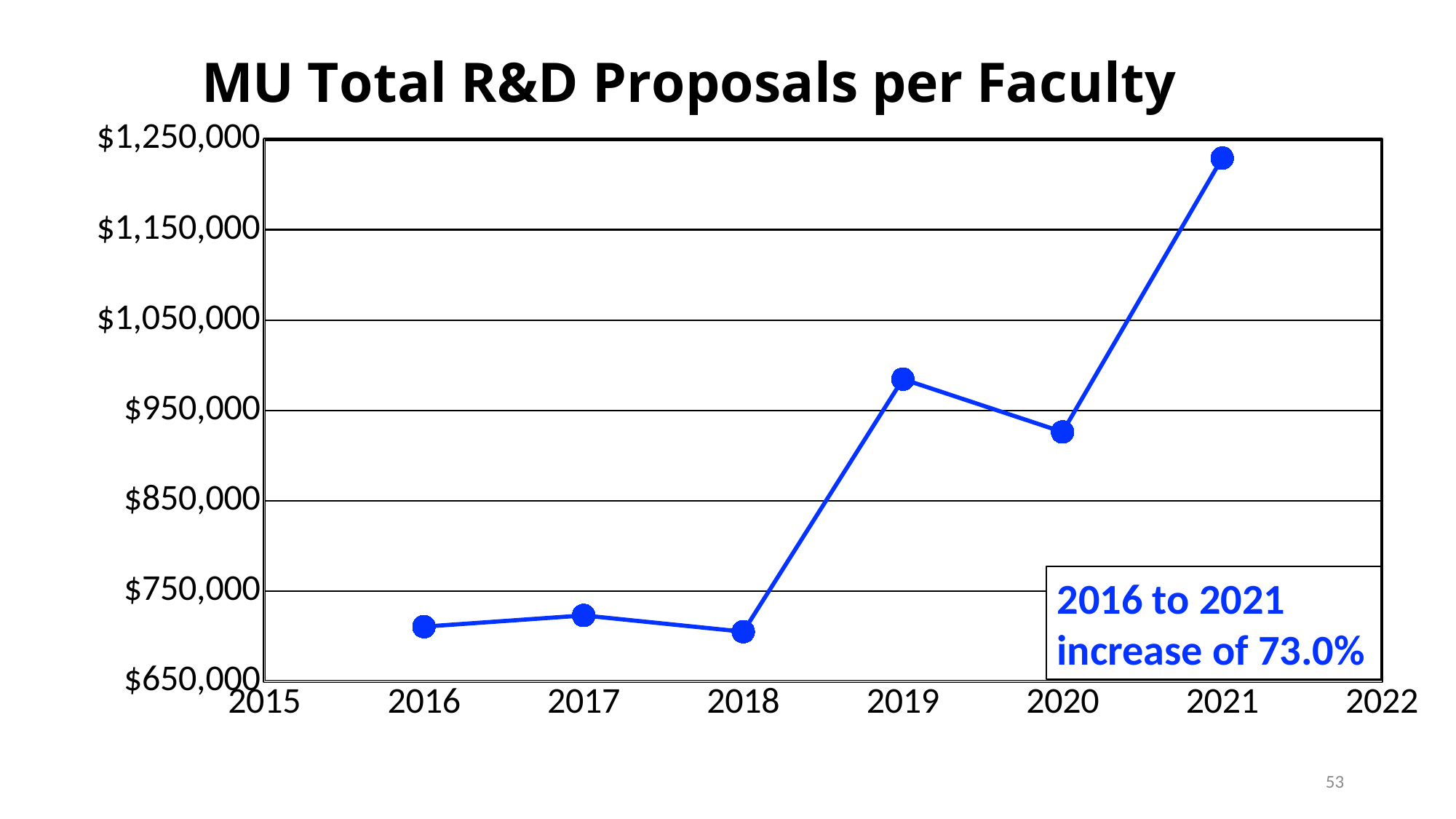
According to the annotation on the chart, what is the percentage increase from 2016 to 2021? 73.0% What kind of chart is shown on the slide? line chart Is the value for 2019 greater or less than $950,000? greater Is the value for 2021 greater or less than $1,150,000? greater How many data points are plotted on the line? 6 Is the value for 2016 greater or less than $750,000? less What is the title of the chart? MU Total R&D Proposals per Faculty Do the values generally rise or fall from 2016 to 2021? rise Which year has the larger value, 2019 or 2020? 2019 Which year has the highest value? 2021